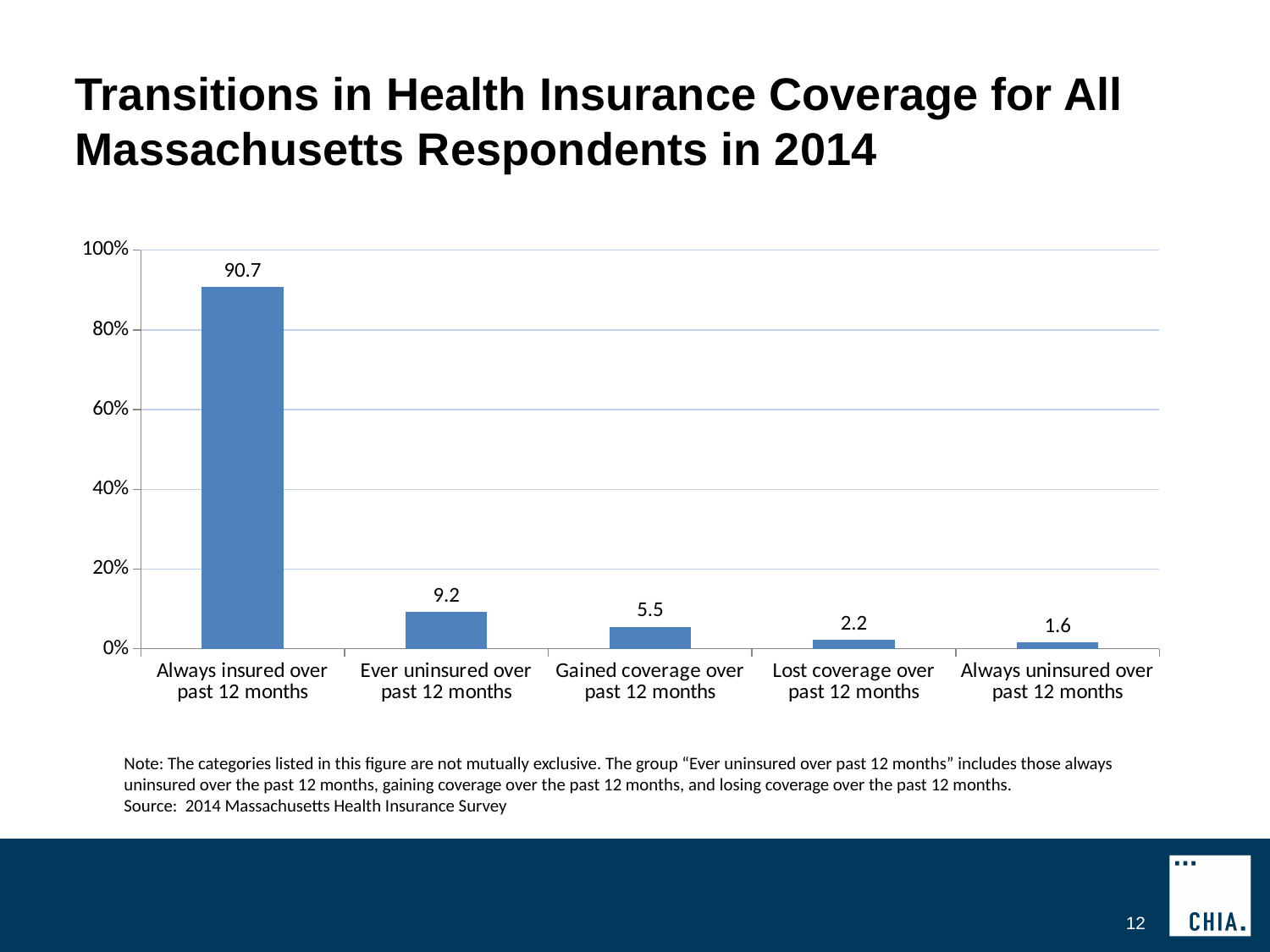
What is the value for "Gained coverage over past 12 months"? 5.5 What is the value for "Always insured over past 12 months"? 90.7 What kind of chart is shown on the slide? Bar chart Which category has the highest value? Always insured over past 12 months What is the value for "Lost coverage over past 12 months"? 2.2 What is the value for "Ever uninsured over past 12 months"? 9.2 Is the value for "Always insured over past 12 months" greater or less than 80%? greater Which is larger, the value for "Lost coverage over past 12 months" or "Always uninsured over past 12 months"? Lost coverage over past 12 months How many categories are shown on the x axis? 5 What is the value for "Always uninsured over past 12 months"? 1.6 What is the difference between the values for "Ever uninsured over past 12 months" and "Gained coverage over past 12 months"? 3.7 Which category has the lowest value? Always uninsured over past 12 months